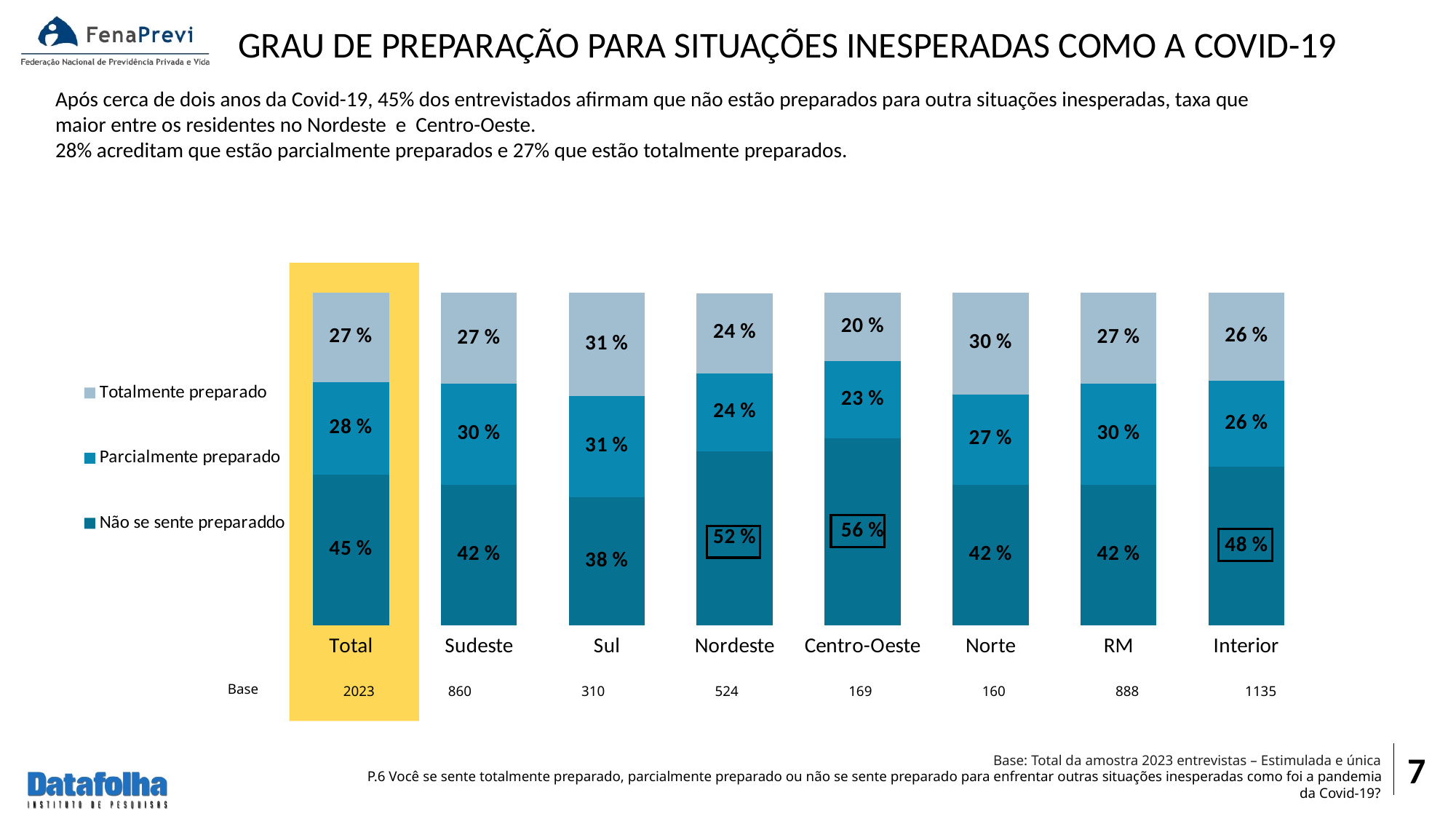
Which category has the lowest value for 'Totalmente preparado'? Centro-Oeste Which category has the highest value for 'Não se sente preparaddo'? Centro-Oeste What is the value for 'Parcialmente preparado' in the Interior bar? 26 % What is the difference between the 'Não se sente preparaddo' values for Nordeste and Sul? 14 % What is the value for 'Totalmente preparado' in the Sul bar? 31 % How many series does the legend list? 3 What is the base (number of interviews) shown for the Nordeste category? 524 Which is larger: the 'Parcialmente preparado' value for Sudeste or for Norte? Sudeste What is the total of the three segments in the Total bar? 100 % How many categories are shown along the x axis of the chart? 8 What type of chart is shown on the slide? Stacked bar chart What is the value for 'Não se sente preparaddo' in the Centro-Oeste bar? 56 %